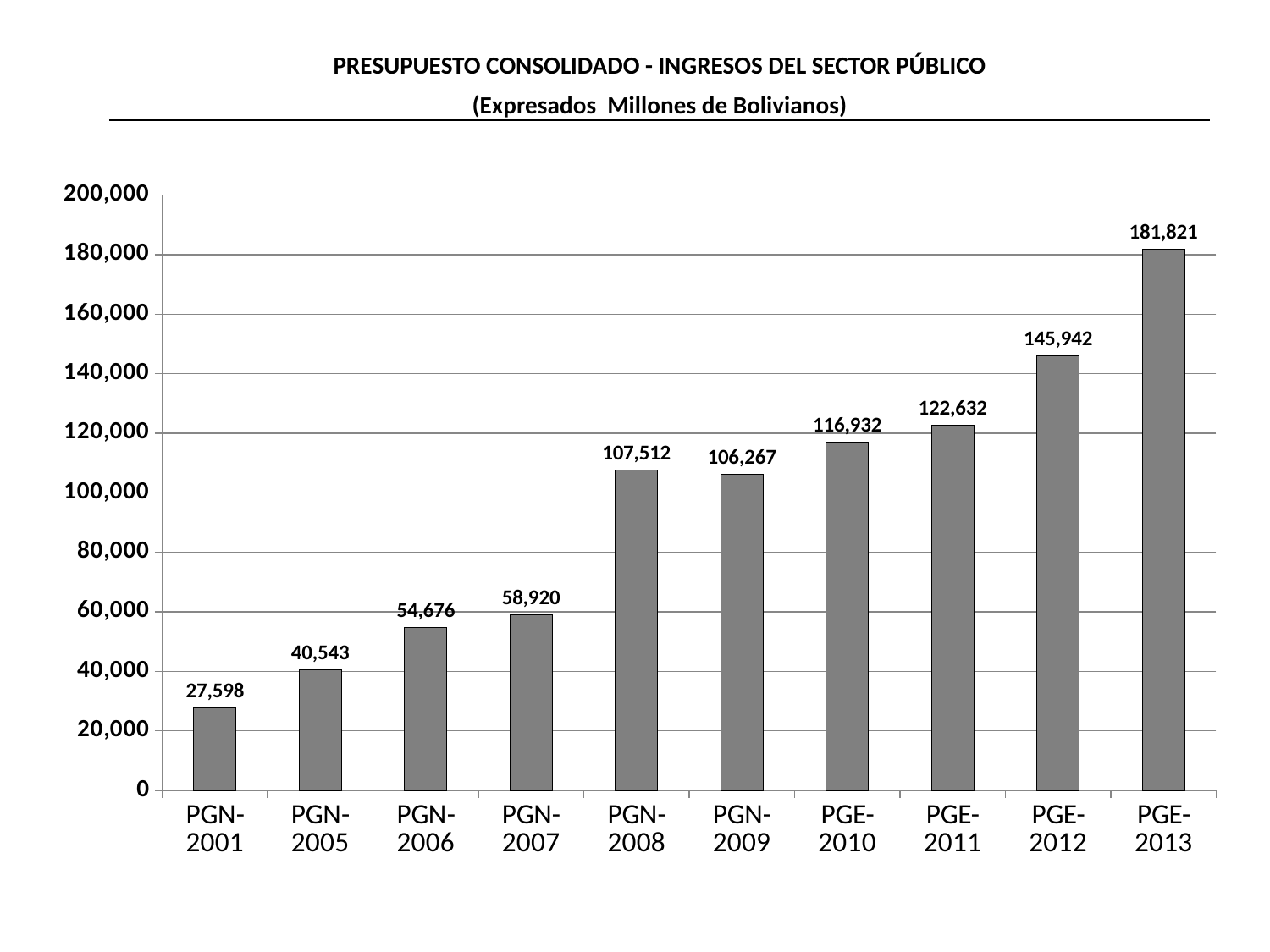
Which category has the lowest value? PGN-2001 What is the value for PGN-2001? 27,598 Which category has the highest value? PGE-2013 How many categories are shown on the x axis? 10 What unit is stated in the chart's subtitle? Millones de Bolivianos What is the value for PGE-2012? 145,942 Is the value for PGE-2011 greater or less than 120,000? greater What is the difference between the values for PGN-2008 and PGN-2009? 1,245 What kind of chart is shown on the slide? bar chart What is the difference between the values for PGE-2013 and PGE-2012? 35,879 What is the value for PGN-2008? 107,512 Which is larger, the value for PGN-2008 or the value for PGN-2009? PGN-2008